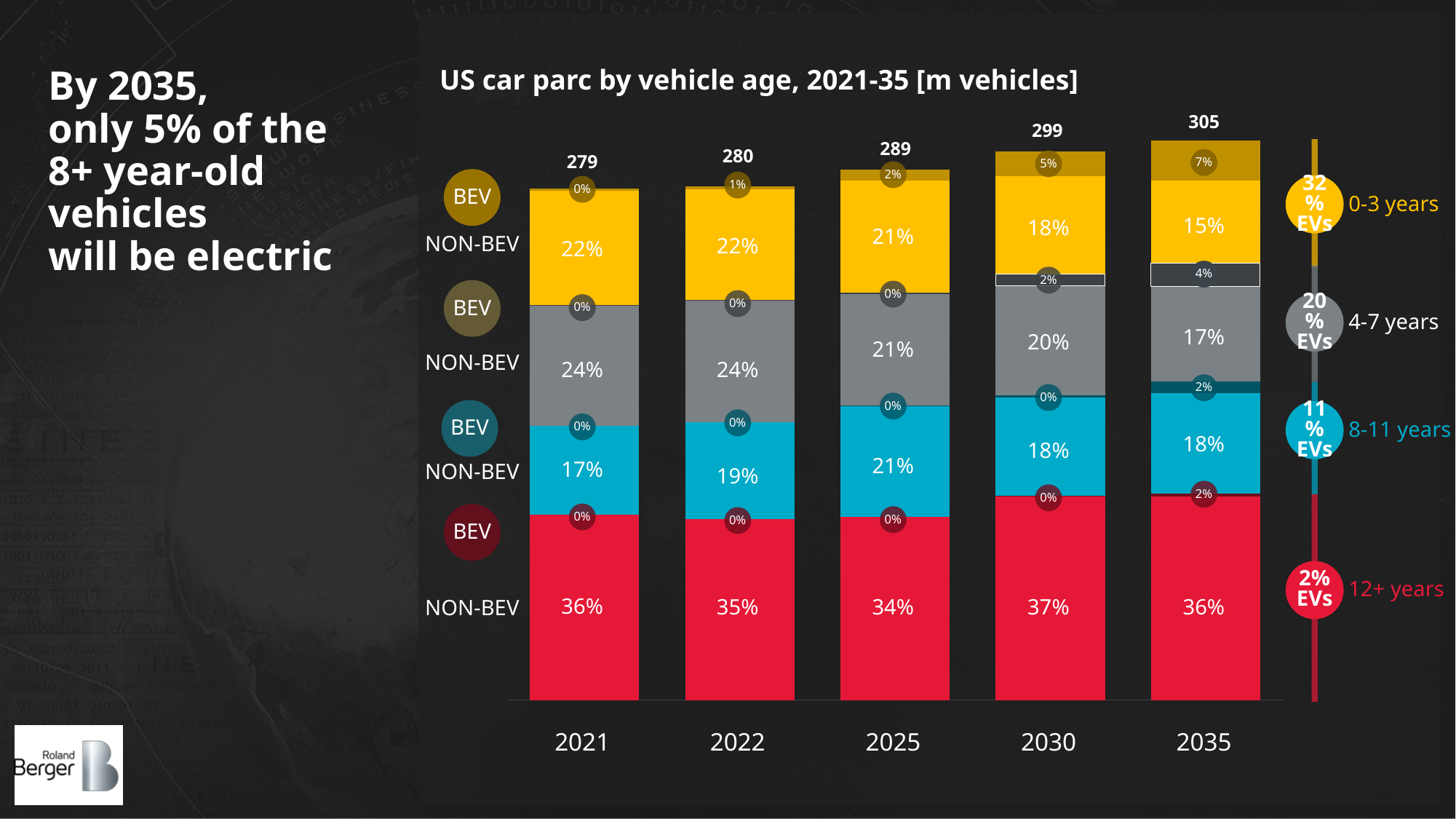
What is the difference between the total car parc in 2035 and in 2021? 26 Which year has the lowest total car parc? 2021 What is the total US car parc shown for 2021? 279 What share of the 2030 car parc is 12+ year-old NON-BEV vehicles? 37% Which is larger in 2025: the 4-7 years NON-BEV share or the 0-3 years BEV share? 4-7 years NON-BEV (21%) Do the total car parc values rise or fall from 2021 to 2035? Rise Which year has the highest total car parc? 2035 How many years are shown on the x axis of the chart? 5 What is the total US car parc shown for 2035? 305 What is the title of the chart? US car parc by vehicle age, 2021-35 [m vehicles] What share of the 2035 car parc is 0-3 year-old BEVs? 7% What kind of chart is shown on the slide? Stacked bar chart